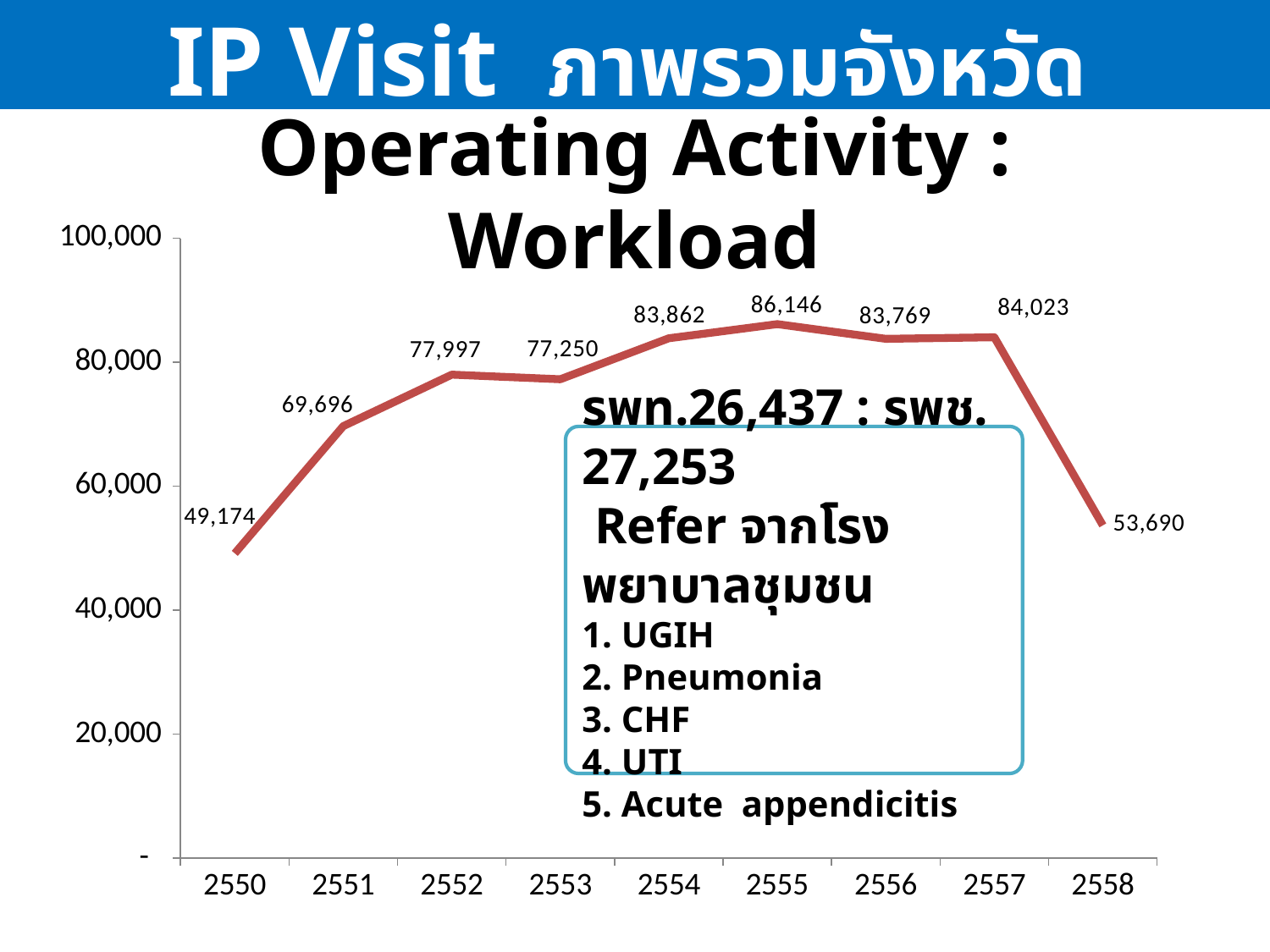
What is the difference between the values for 2557 and 2558? 30,333 Which year has the highest value? 2555 What is the value for 2550? 49,174 What is the difference between the values for 2555 and 2550? 36,972 What is the value for 2558? 53,690 How many years are plotted on the x axis? 9 Which year has the lowest value? 2550 What is the value for 2553? 77,250 What kind of chart is shown? line chart Which is larger, the value for 2552 or the value for 2553? 2552 Is the value for 2551 greater or less than 60,000? greater What is the value for 2555? 86,146